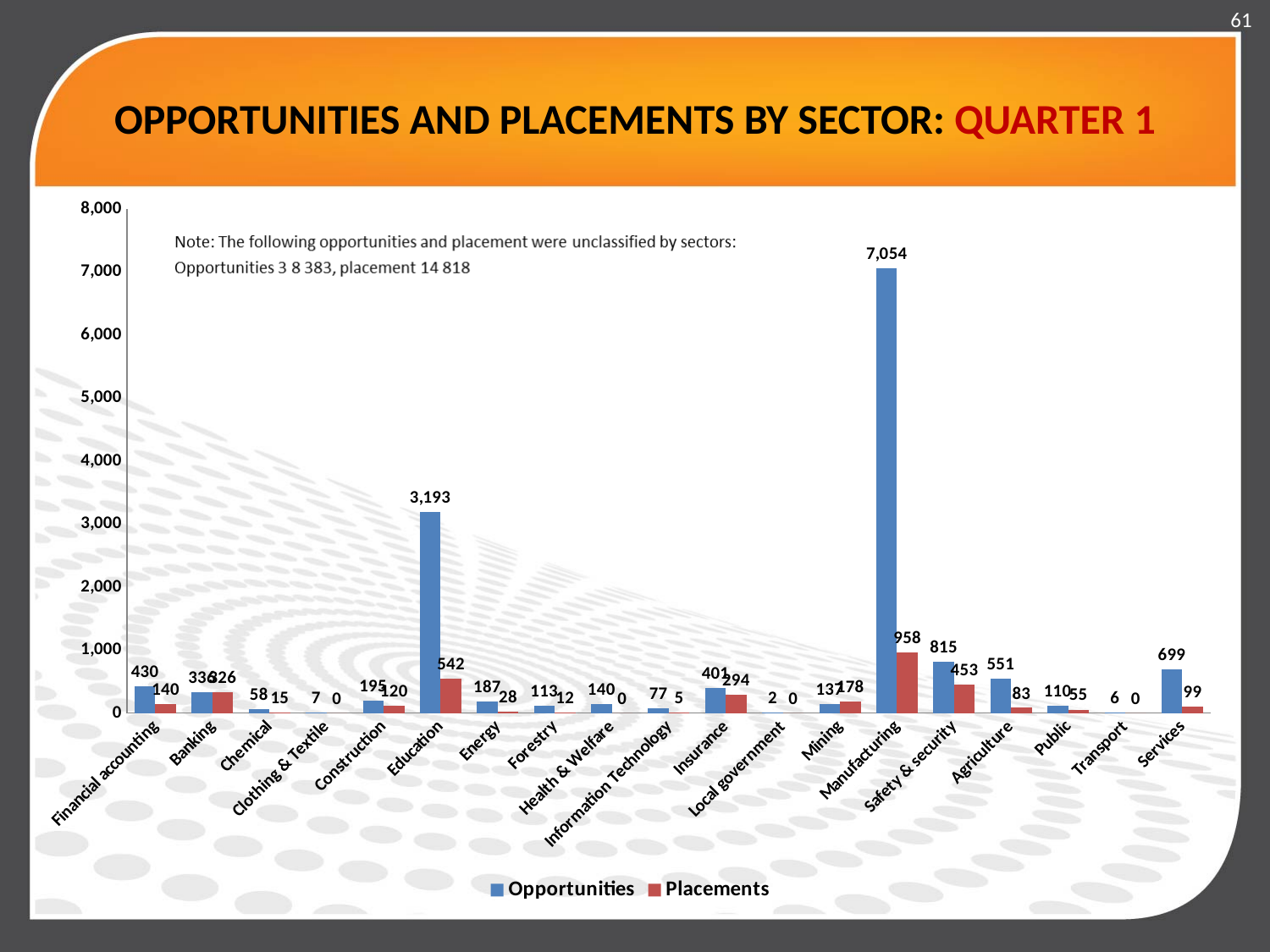
Which sector has the highest number of Opportunities? Manufacturing Which sector has more Opportunities, Safety & security or Services? Safety & security What kind of chart is shown on the slide? bar chart How many sectors are shown on the x axis? 19 What are the two series named in the legend? Opportunities and Placements What is the difference between Opportunities and Placements for Manufacturing? 6,096 What is the number of Opportunities for Manufacturing? 7,054 What is the number of Placements for Insurance? 294 How many series does the legend list? 2 Is the value of Opportunities for Education greater or less than 3,000? greater What is the number of Placements for Education? 542 What is the difference between Opportunities and Placements for Education? 2,651